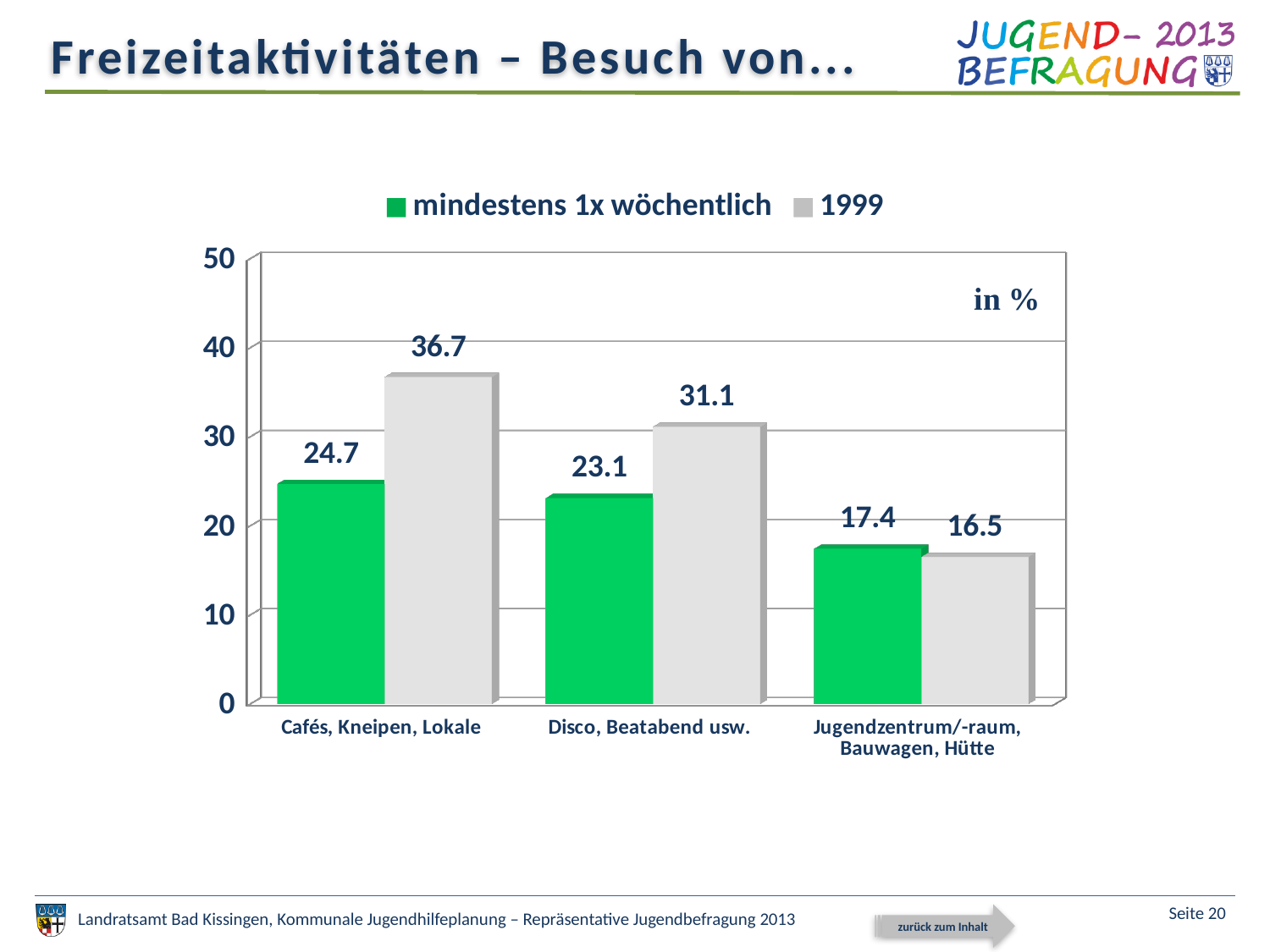
What is the 1999 value for Disco, Beatabend usw.? 31.1 How many series does the legend list? 2 What is the value for 'mindestens 1x wöchentlich' for Cafés, Kneipen, Lokale? 24.7 What is the 1999 value for Jugendzentrum/-raum, Bauwagen, Hütte? 16.5 Is the 1999 value for Cafés, Kneipen, Lokale greater or less than 30? greater For Jugendzentrum/-raum, Bauwagen, Hütte, which is larger: the 'mindestens 1x wöchentlich' value or the 1999 value? mindestens 1x wöchentlich What kind of chart is shown on the slide? bar chart How many categories are shown on the x axis? 3 Which category has the lowest 'mindestens 1x wöchentlich' value? Jugendzentrum/-raum, Bauwagen, Hütte Which category has the highest 1999 value? Cafés, Kneipen, Lokale What is the difference between the 1999 value and the 'mindestens 1x wöchentlich' value for Disco, Beatabend usw.? 8 What is the difference between the 1999 value and the 'mindestens 1x wöchentlich' value for Cafés, Kneipen, Lokale? 12